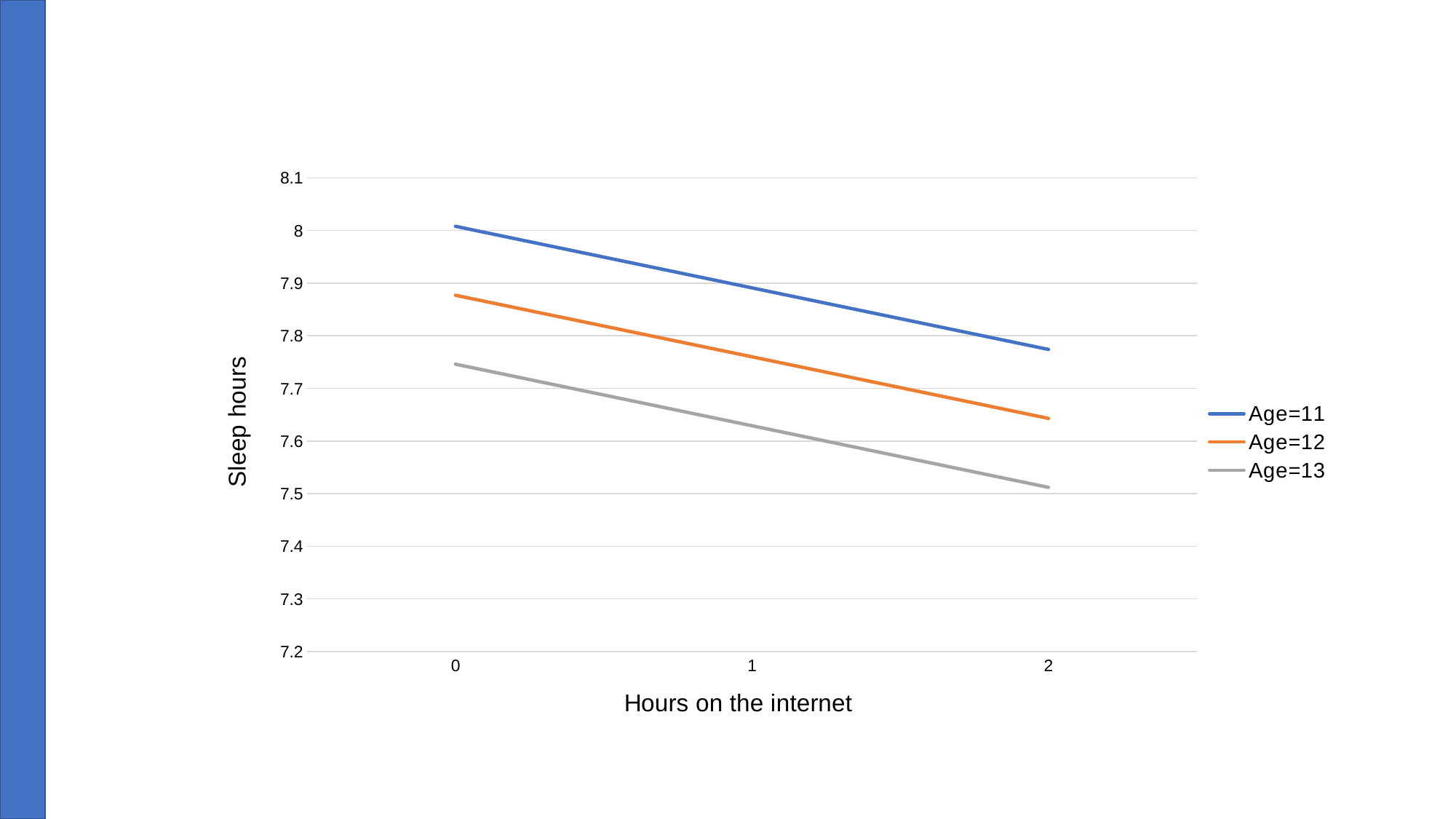
Which series has the highest sleep hours at 0 hours on the internet? Age=11 At 1 hour on the internet, which series has more sleep hours, Age=12 or Age=13? Age=12 Is the sleep hours value for Age=13 at 2 hours on the internet greater or less than 7.6? less Do sleep hours rise or fall as hours on the internet increase for Age=13? fall What is the label of the y axis? Sleep hours Do sleep hours rise or fall as hours on the internet increase for Age=11? fall Is the sleep hours value for Age=11 at 0 hours on the internet greater or less than 7.9? greater What kind of chart is shown on the slide? line chart Which series has the lowest sleep hours at 2 hours on the internet? Age=13 Is the sleep hours value for Age=13 at 0 hours on the internet greater or less than 7.7? greater How many points are shown on the x axis (Hours on the internet)? 3 How many series does the legend list? 3